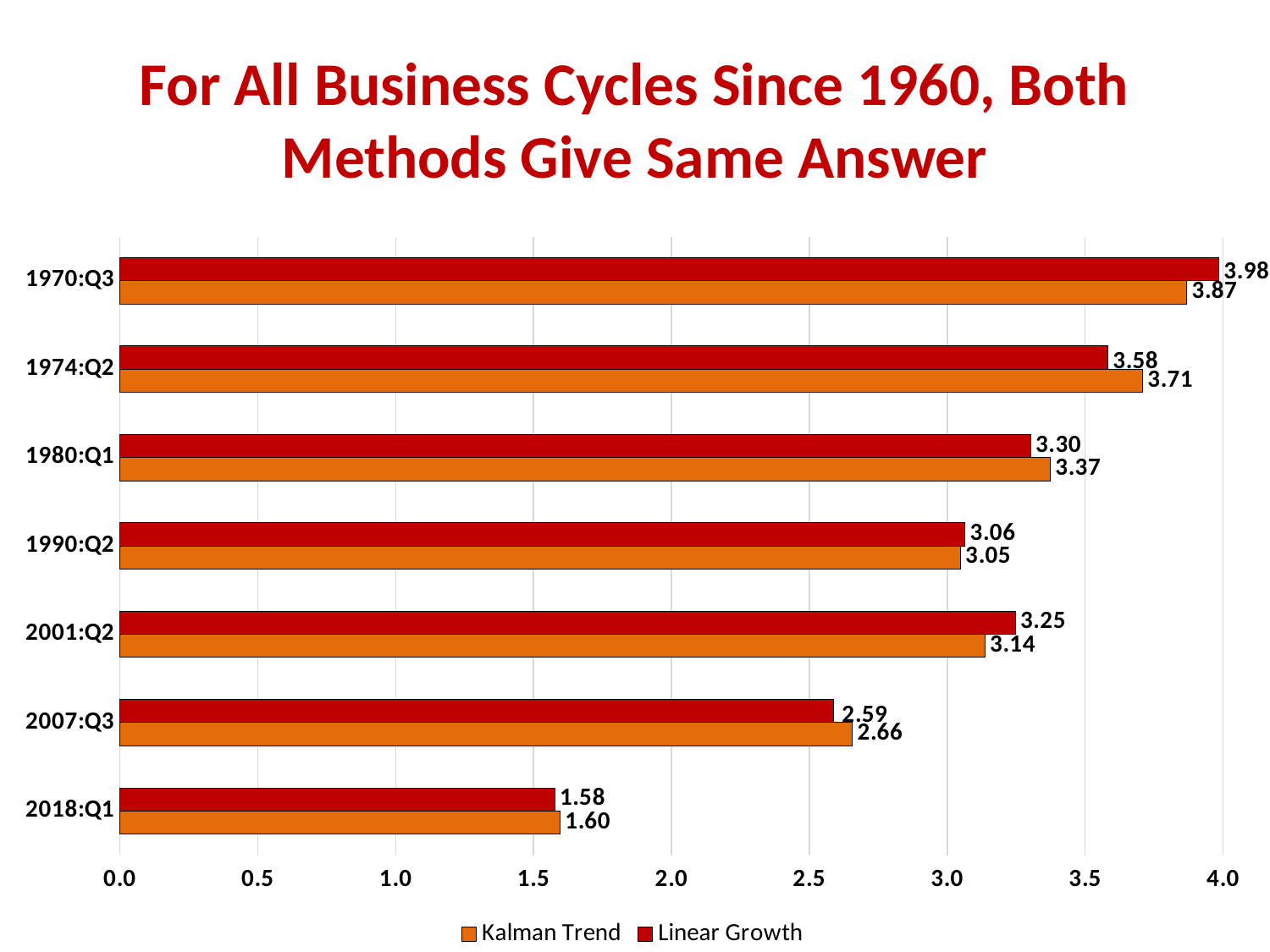
Which is larger for 2001:Q2, the Kalman Trend value or the Linear Growth value? Linear Growth Is the Linear Growth value for 2007:Q3 greater or less than 3.0? less How many series does the legend list? 2 Which category has the highest Linear Growth value? 1970:Q3 Which category has the lowest Kalman Trend value? 2018:Q1 What is the Kalman Trend value for 1974:Q2? 3.71 What kind of chart is shown on the slide? bar chart What is the Kalman Trend value for 2018:Q1? 1.60 What is the Linear Growth value for 1970:Q3? 3.98 Which series is shown in orange in the legend? Kalman Trend What is the difference between the Kalman Trend and Linear Growth values for 1974:Q2? 0.13 How many business cycle categories are shown on the chart? 7